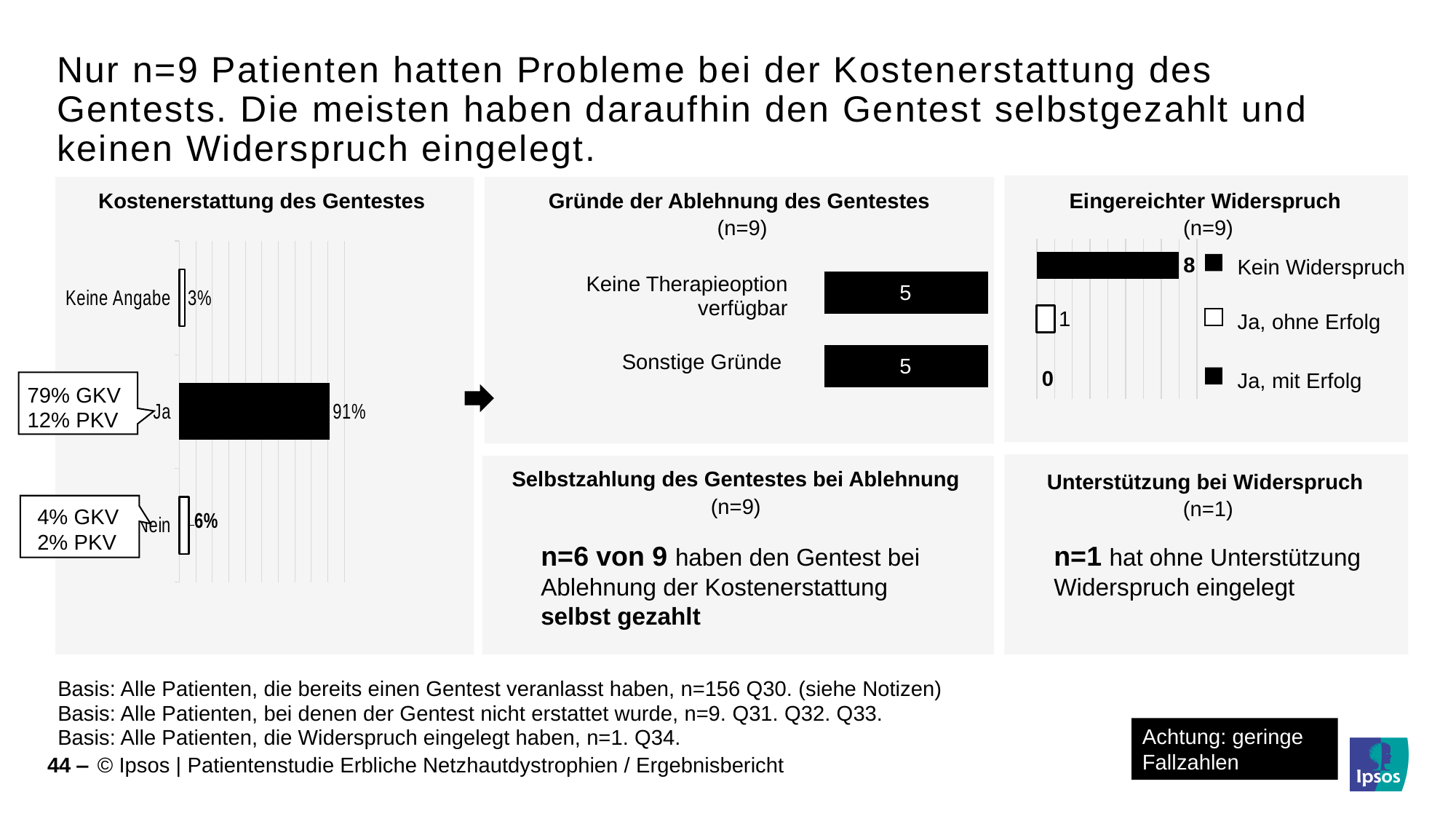
In the 'Eingereichter Widerspruch' chart, what is the value for 'Ja, mit Erfolg'? 0 In the 'Kostenerstattung des Gentestes' chart, what is the value for 'Ja'? 91% In the 'Kostenerstattung des Gentestes' chart, what is the difference between the values for 'Ja' and 'Nein'? 85% In the 'Kostenerstattung des Gentestes' chart, what is the value for 'Keine Angabe'? 3% What kind of chart is the 'Eingereichter Widerspruch' chart? bar chart In the 'Kostenerstattung des Gentestes' chart, how many categories are shown? 3 In the 'Kostenerstattung des Gentestes' chart, which category has the highest value? Ja In the 'Kostenerstattung des Gentestes' chart, which category has the lowest value? Keine Angabe In the 'Eingereichter Widerspruch' chart, what is the value for 'Kein Widerspruch'? 8 In the 'Eingereichter Widerspruch' chart, how many entries does the legend list? 3 In the 'Gründe der Ablehnung des Gentestes' chart, what is the value for 'Sonstige Gründe'? 5 In the 'Gründe der Ablehnung des Gentestes' chart, what is the value for 'Keine Therapieoption verfügbar'? 5